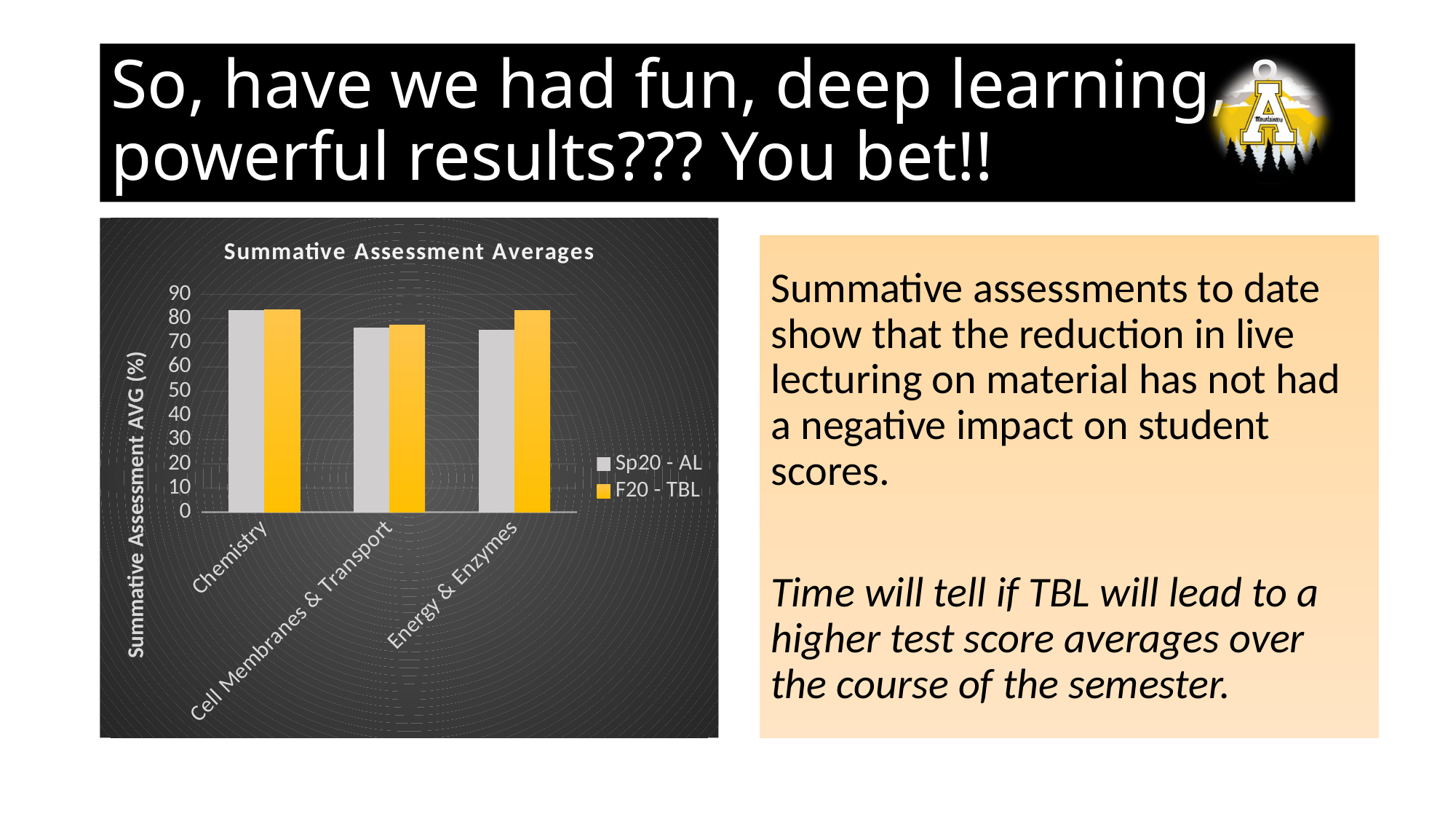
What is the label of the vertical axis of the chart? Summative Assessment AVG (%) Which category has the lowest F20 - TBL value? Cell Membranes & Transport Is the F20 - TBL value for Energy & Enzymes greater or less than 80? greater Is the F20 - TBL value for Cell Membranes & Transport greater or less than 80? less For Energy & Enzymes, which series has the larger value, Sp20 - AL or F20 - TBL? F20 - TBL How many series does the chart legend list? 2 How many categories are shown on the x axis of the chart? 3 What is the title of the chart? Summative Assessment Averages Which category has the highest Sp20 - AL value? Chemistry What type of chart is shown on the slide? bar chart Is the Sp20 - AL value for Chemistry greater or less than 80? greater